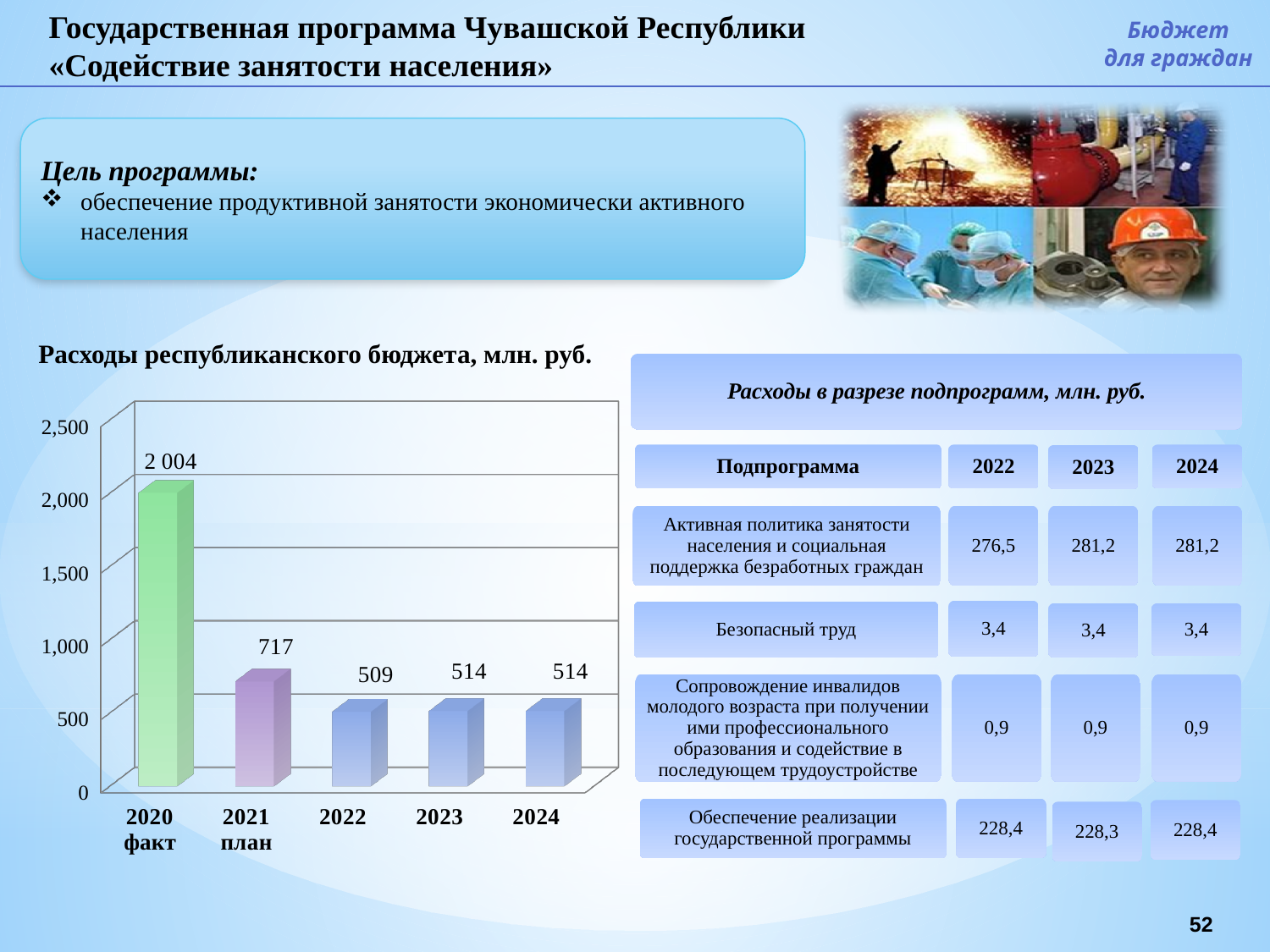
Which category has the lowest value in the chart? 2022 What is the title of the chart on the slide? Расходы республиканского бюджета, млн. руб. What is the difference between the values for 2020 факт and 2021 план? 1 287 What is the value for 2021 план in the chart? 717 What is the value for 2022 in the chart? 509 Is the value for 2021 план greater or less than 500? greater Which category has the highest value in the chart? 2020 факт What is the difference between the values for 2023 and 2022? 5 What kind of chart is shown on the slide? bar chart Which is larger, the value for 2021 план or the value for 2024? 2021 план What is the value for 2020 факт in the chart 'Расходы республиканского бюджета, млн. руб.'? 2 004 How many categories are shown on the x axis of the chart? 5